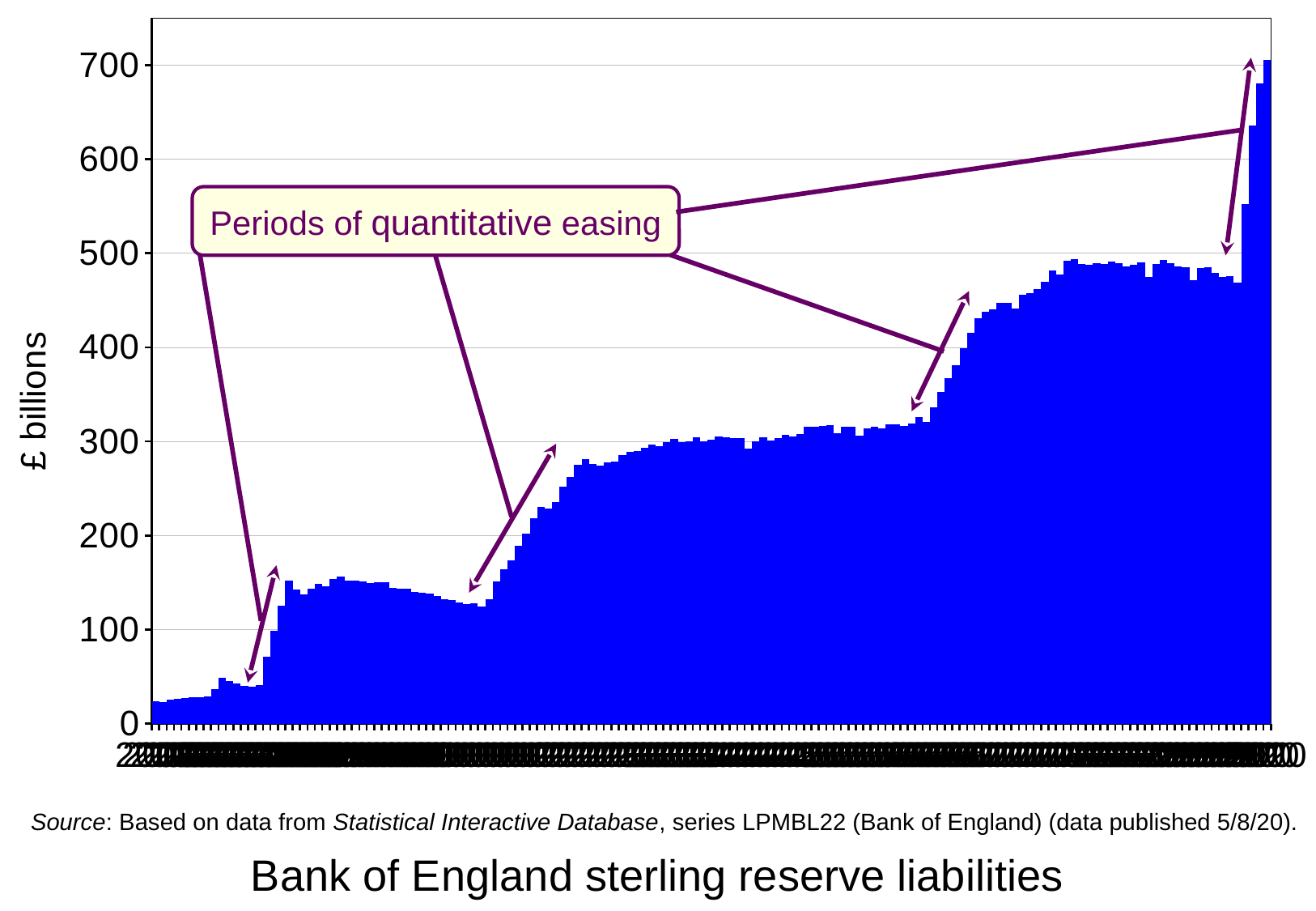
Is the highest value on the chart greater or less than 600? greater Where on the x axis does the lowest value occur, at the left end or the right end? the left end What is the label on the y axis? £ billions Is the lowest value on the chart greater or less than 100? less Is the value of the first bar on the left greater or less than 100? less Which is larger, the value of the first bar on the left or the value of the last bar on the right? the last bar on the right Where on the x axis does the highest value occur, at the left end or the right end? the right end What does the annotation box on the chart say? Periods of quantitative easing What kind of chart is shown on the slide? bar chart Overall, do the values rise or fall from left to right along the x axis? rise